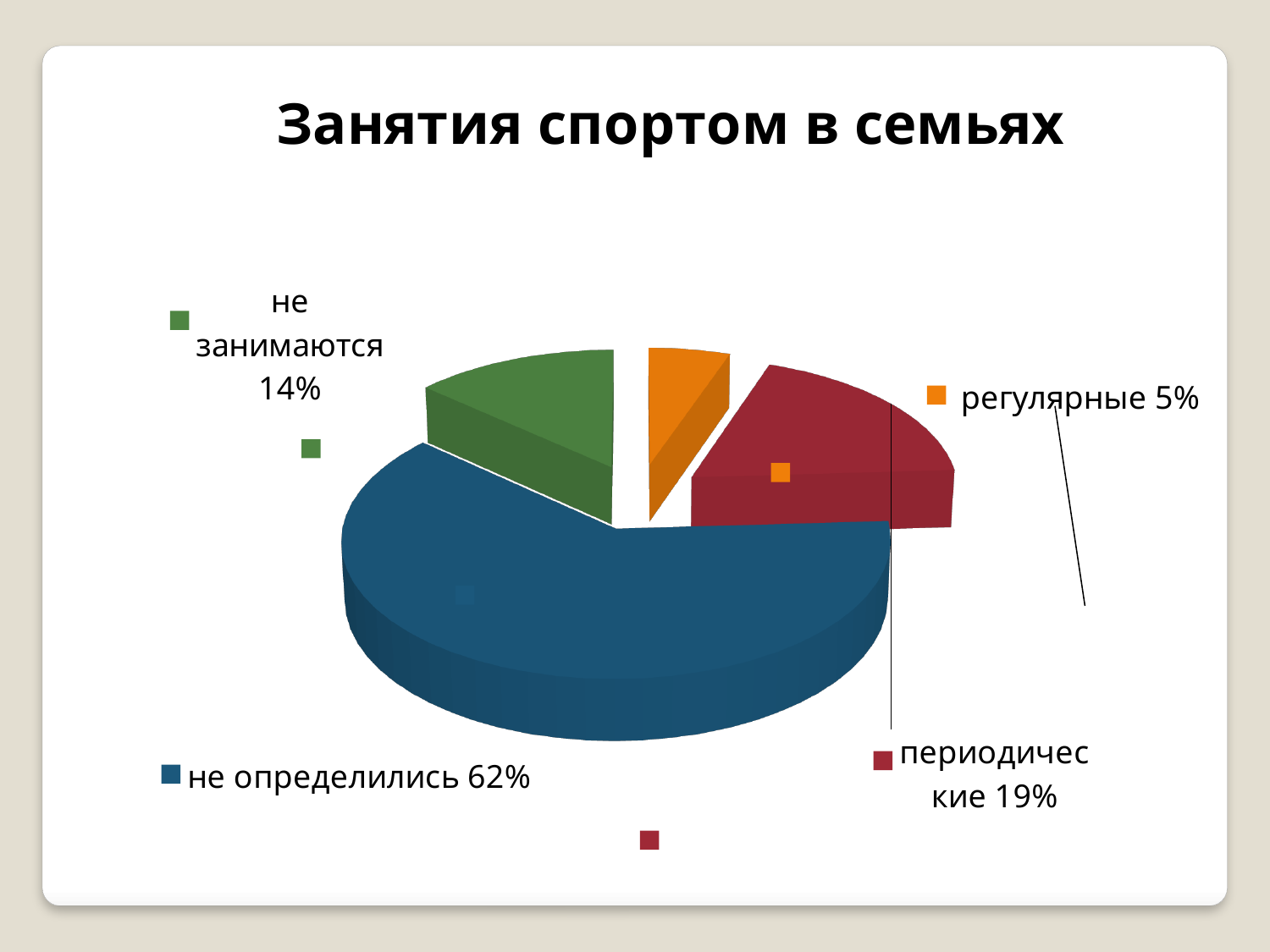
What kind of chart is shown on the slide? pie chart What percentage is shown for 'регулярные'? 5% What percentage is shown for 'не определились'? 62% What is the title of the chart? Занятия спортом в семьях Which category has the smallest share of the pie? регулярные What colour is the slice for 'не определились'? blue How many slices does the pie chart have? 4 What is the difference between the shares for 'периодические' and 'не занимаются'? 5% What percentage is shown for 'не занимаются'? 14% What percentage is shown for 'периодические'? 19% Which is larger, the share for 'не занимаются' or the share for 'регулярные'? не занимаются Which category has the largest share of the pie? не определились